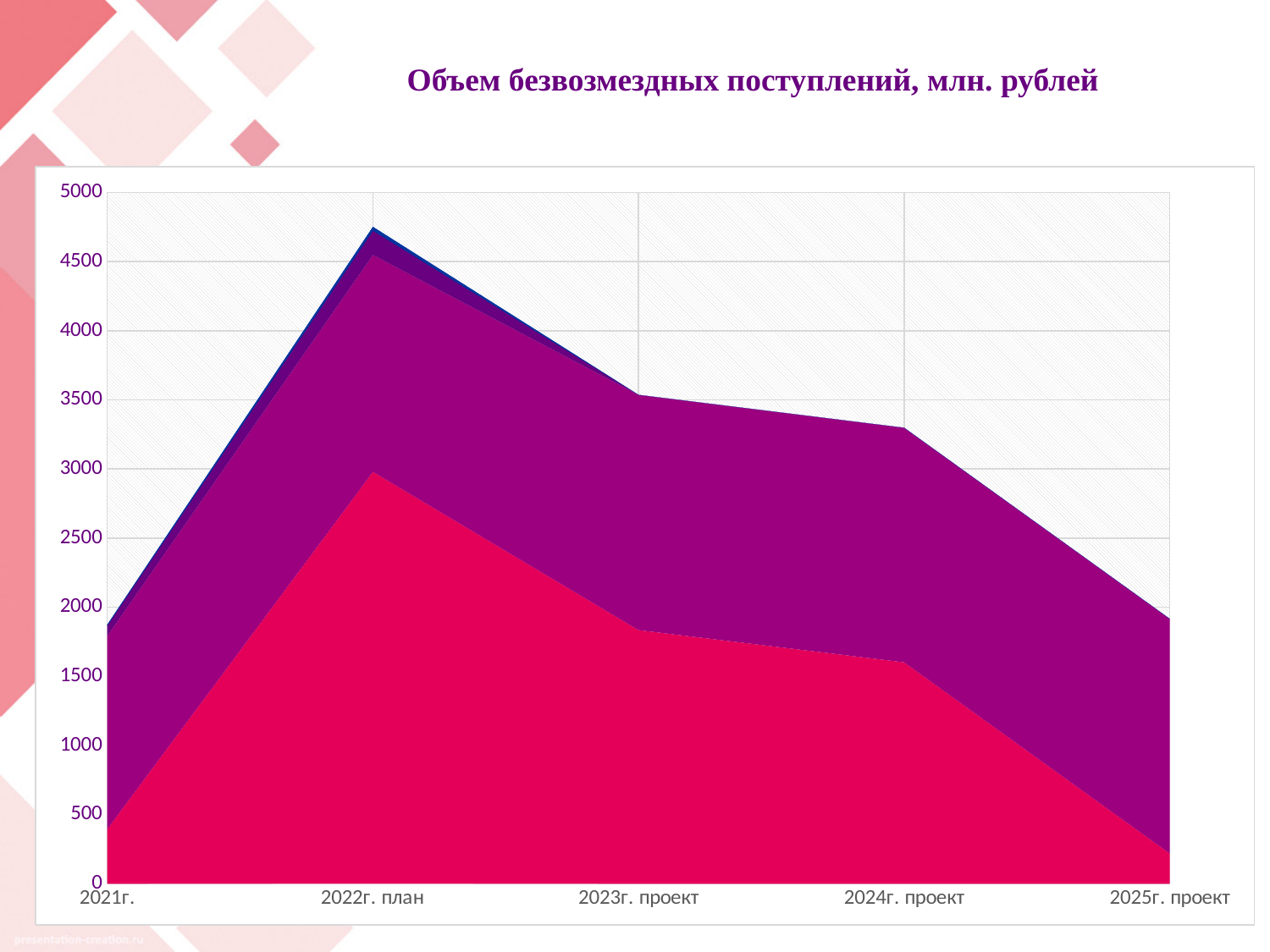
Is the total (top of the stacked area) for 2022г. план greater or less than 4500? greater Which has the larger total: 2022г. план or 2025г. проект? 2022г. план Is the total (top of the stacked area) for 2024г. проект greater or less than 3500? less Is the value of the bottom (red) series for 2023г. проект greater or less than 1500? greater Which category has the highest total (top of the stacked area)? 2022г. план How many categories are shown along the x axis? 5 What kind of chart is shown on the slide? Area chart Do the totals rise or fall from 2022г. план to 2025г. проект? fall What is the title of the chart? Объем безвозмездных поступлений, млн. рублей Which category has the highest value for the bottom (red) series? 2022г. план